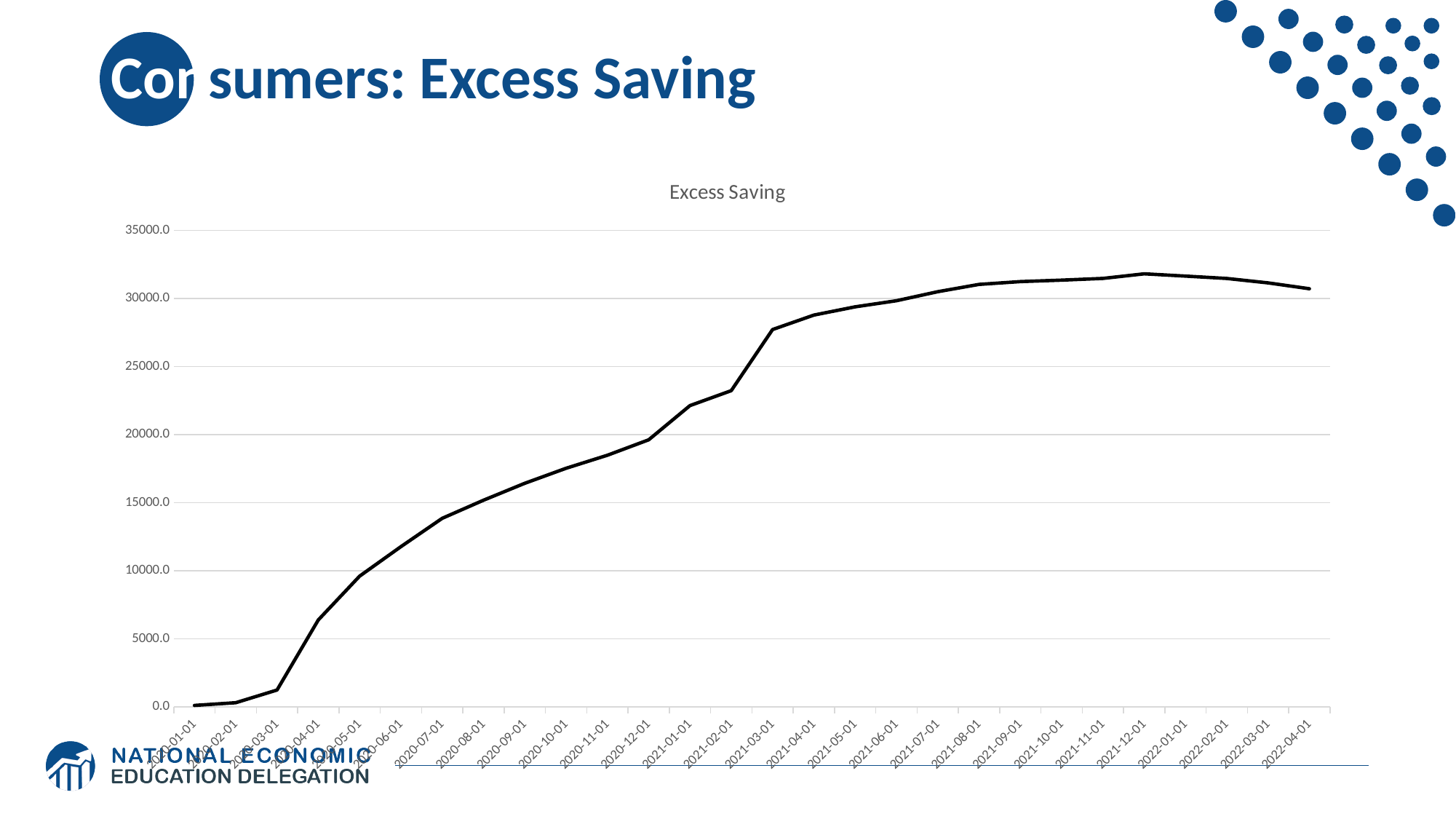
Is the value for 2020-12-01 greater or less than 20000.0? less At which date does the Excess Saving line reach its highest value? 2021-12-01 Is the value for 2021-03-01 greater or less than 25000.0? greater At which date is the Excess Saving value lowest? 2020-01-01 Is the value for 2020-07-01 greater or less than 15000.0? less What is the title of the chart? Excess Saving How many monthly data points are plotted on the x axis? 28 Does the Excess Saving line generally rise or fall from 2020-01-01 to 2021-12-01? rise What kind of chart is shown on the slide? line chart Which date has the larger Excess Saving value, 2020-12-01 or 2021-03-01? 2021-03-01